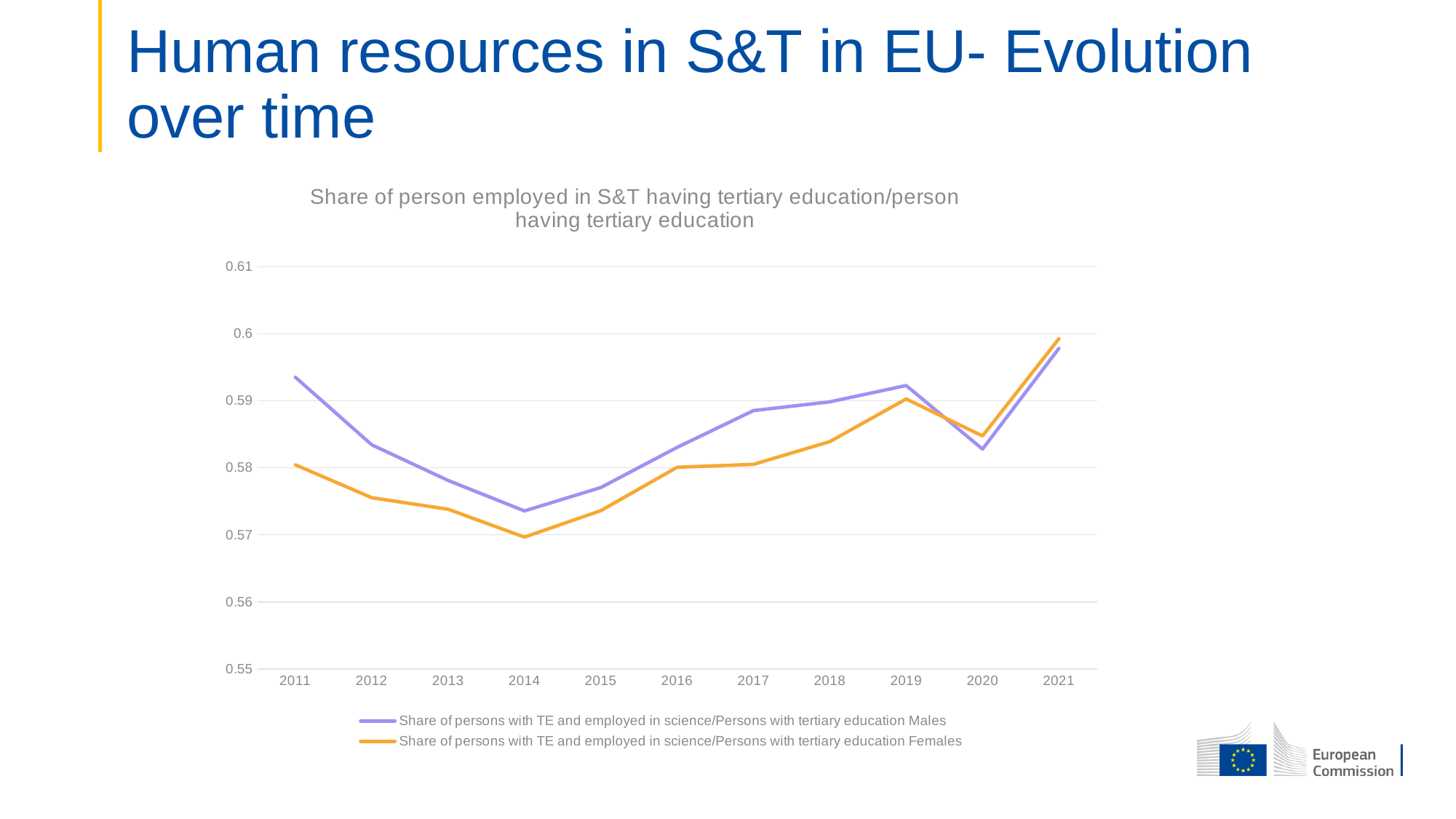
What kind of chart is shown on the slide? Line chart Is the value for Males in 2011 greater or less than 0.59? greater Is the value for Females in 2018 greater or less than 0.58? greater Is the value for Females in 2021 greater or less than 0.59? greater In which year is the Females series at its lowest? 2014 How many series does the legend list? 2 In which year is the Males series at its lowest? 2014 In 2011, which series has the higher value, Males or Females? Males Do the values for the Males series rise or fall from 2011 to 2014? Fall In which year is the Females series at its highest? 2021 How many years are plotted along the x axis? 11